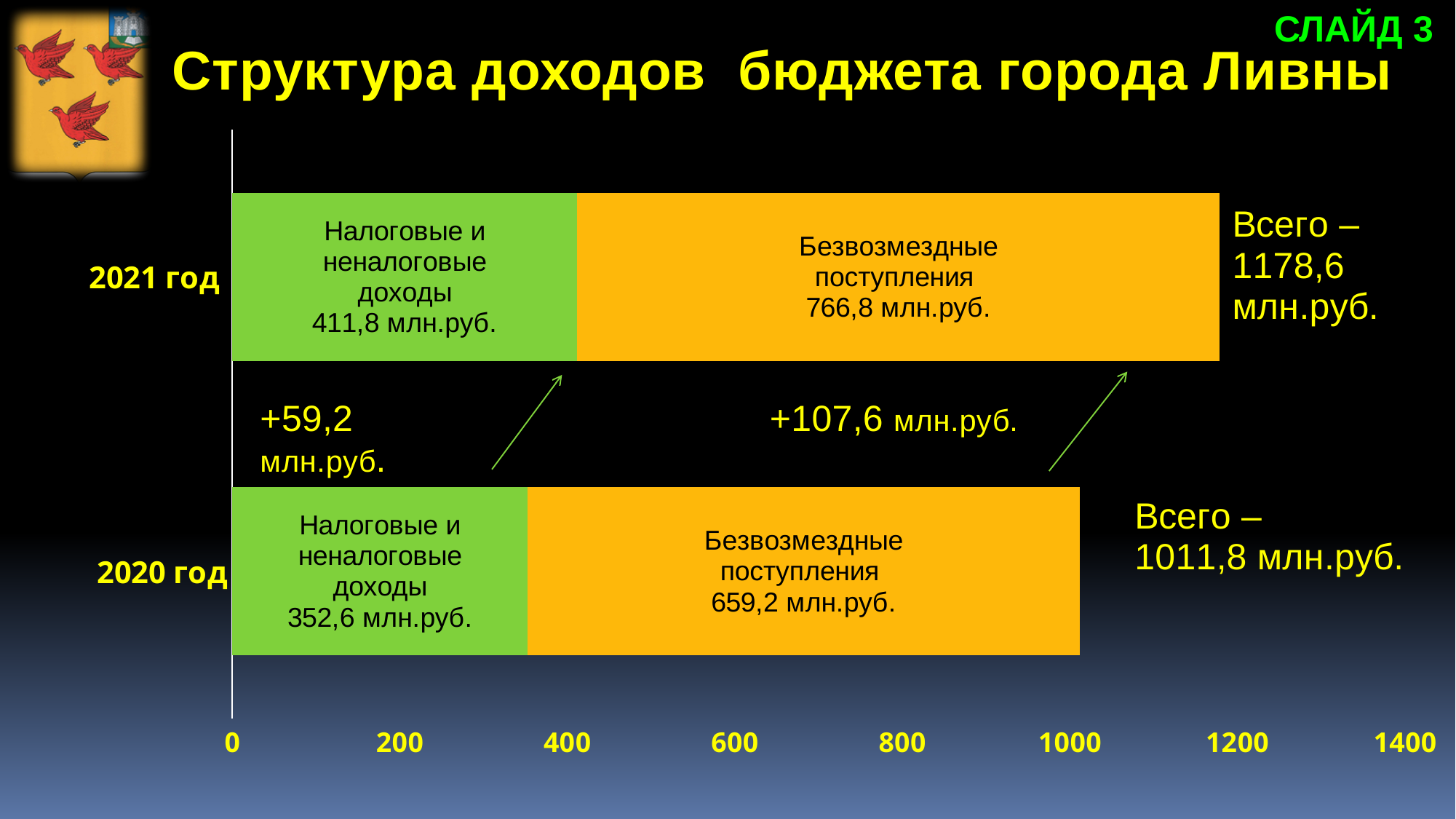
By how much did gratuitous receipts increase from 2020 to 2021? +107,6 млн.руб. Which is larger in 2021: tax and non-tax revenues or gratuitous receipts? Безвозмездные поступления What is the total budget revenue shown for 2021? 1178,6 млн.руб. By how much did tax and non-tax revenues increase from 2020 to 2021? +59,2 млн.руб. Which year has the higher total budget revenue? 2021 год Is the total for 2020 greater or less than 1000 on the axis? greater What is the value of gratuitous receipts (Безвозмездные поступления) for 2020? 659,2 млн.руб. What colour represents gratuitous receipts (Безвозмездные поступления) in the chart? Orange How many years (bars) are shown in the chart? 2 What is the total budget revenue shown for 2020? 1011,8 млн.руб. What kind of chart is shown on the slide? Stacked bar chart What is the value of tax and non-tax revenues (Налоговые и неналоговые доходы) for 2021? 411,8 млн.руб.